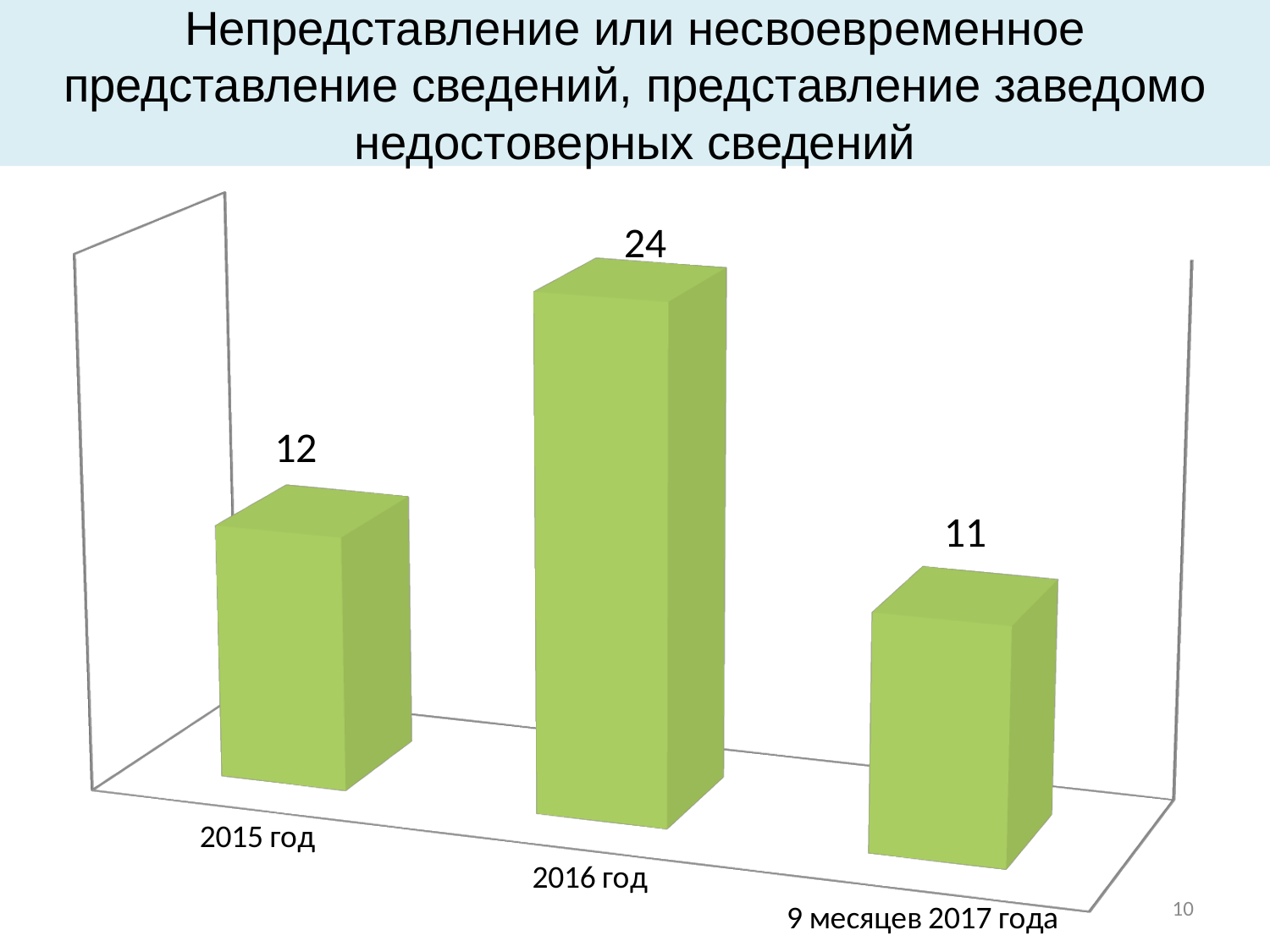
Which category has the lowest value? 9 месяцев 2017 года Which is larger, the value for 2016 год or the value for 9 месяцев 2017 года? 2016 год What kind of chart is shown on the slide? bar chart How many categories are shown on the chart? 3 What is the value for 2015 год? 12 Which category has the highest value? 2016 год Does the value rise or fall from 2016 год to 9 месяцев 2017 года? fall What colour are the bars on the chart? green What is the value for 2016 год? 24 What is the difference between the values for 2015 год and 9 месяцев 2017 года? 1 What is the difference between the values for 2016 год and 2015 год? 12 What is the value for 9 месяцев 2017 года? 11